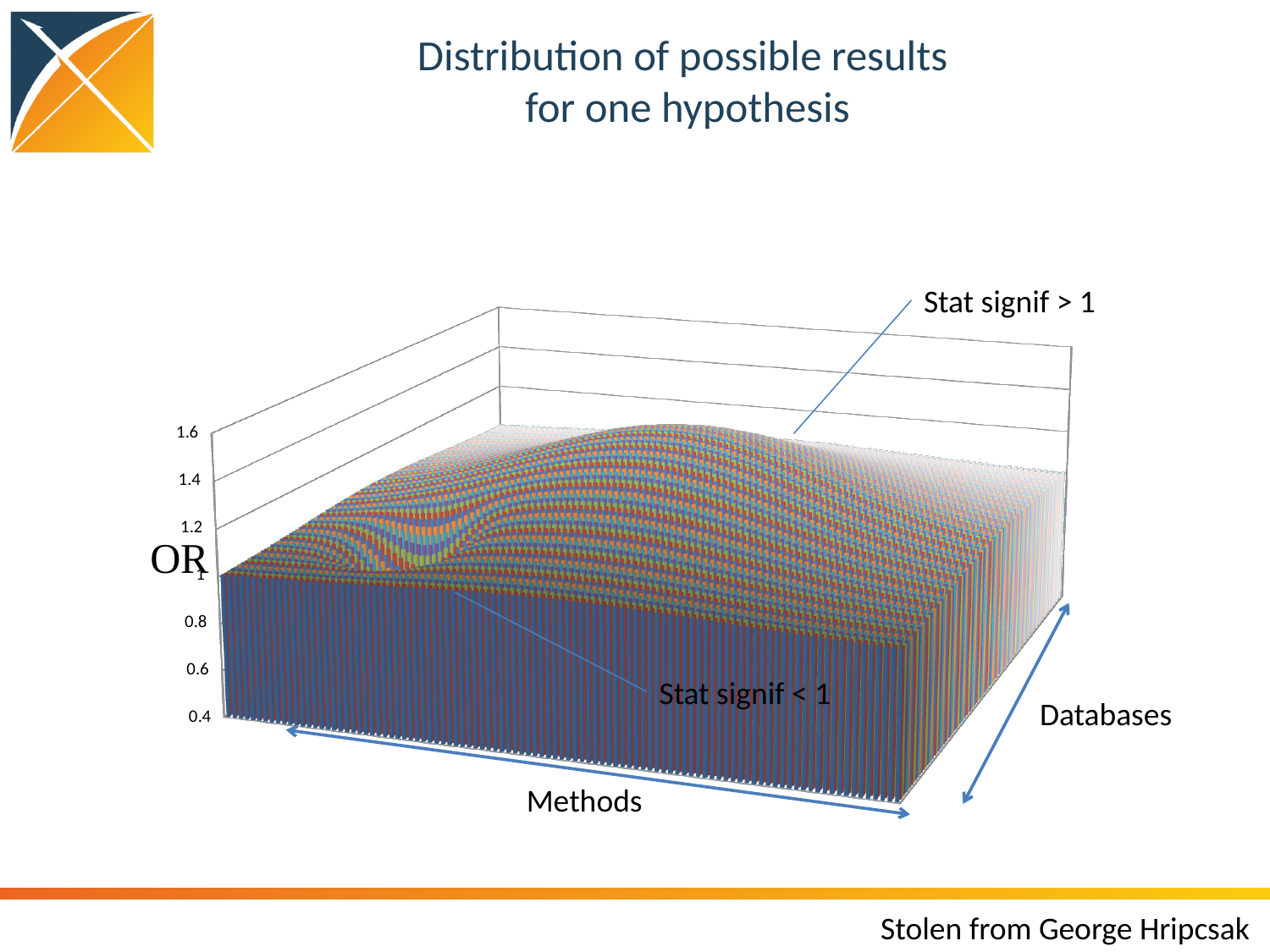
What is the highest tick value shown on the vertical axis? 1.6 How many tick labels are shown on the vertical axis? 7 Is the peak of the surface greater or less than 1.2 on the OR axis? greater What is the title of the chart on the slide? Distribution of possible results for one hypothesis Is the peak of the surface greater or less than 1.6 on the OR axis? less What label is shown on the vertical axis of the chart? OR What kind of chart is shown on the slide? 3D surface chart What is the lowest tick value shown on the vertical axis? 0.4